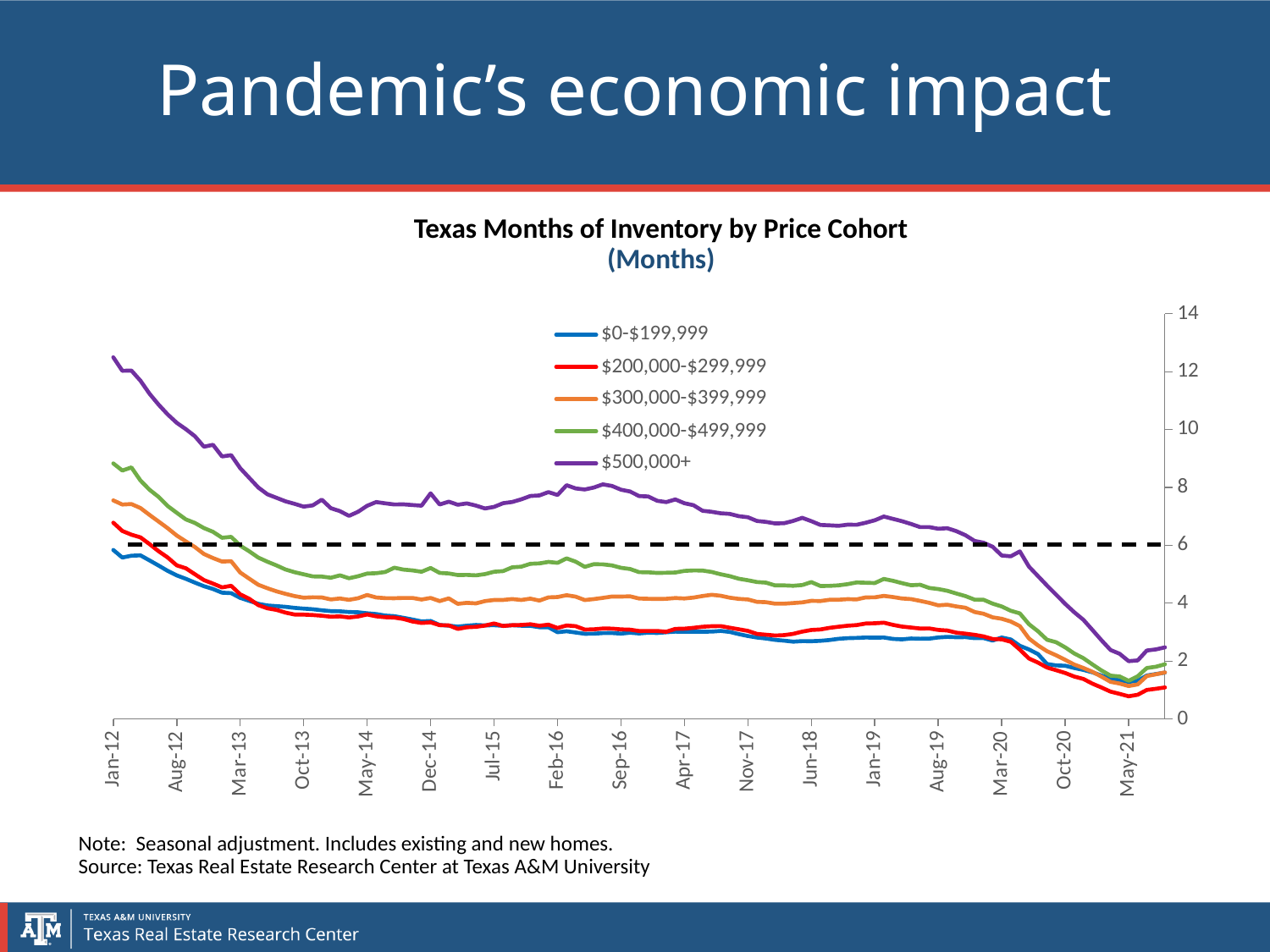
What is the title of the chart? Texas Months of Inventory by Price Cohort How many series does the legend list? 5 At what value on the y-axis is the horizontal dashed line drawn? 6 Is the value for $500,000+ at Jan-12 greater or less than 12? greater Which price cohort has the highest months of inventory at Jan-12? $500,000+ At Jan-12, which is larger: $400,000-$499,999 or $200,000-$299,999? $400,000-$499,999 Is the value for $500,000+ at May-21 greater or less than 4? less Does the $500,000+ series rise or fall overall from Jan-12 to May-21? fall Which price cohort has the lowest months of inventory at Jan-12? $0-$199,999 Is the value for $400,000-$499,999 at Jan-12 greater or less than 8? greater What kind of chart is shown on the slide? line chart